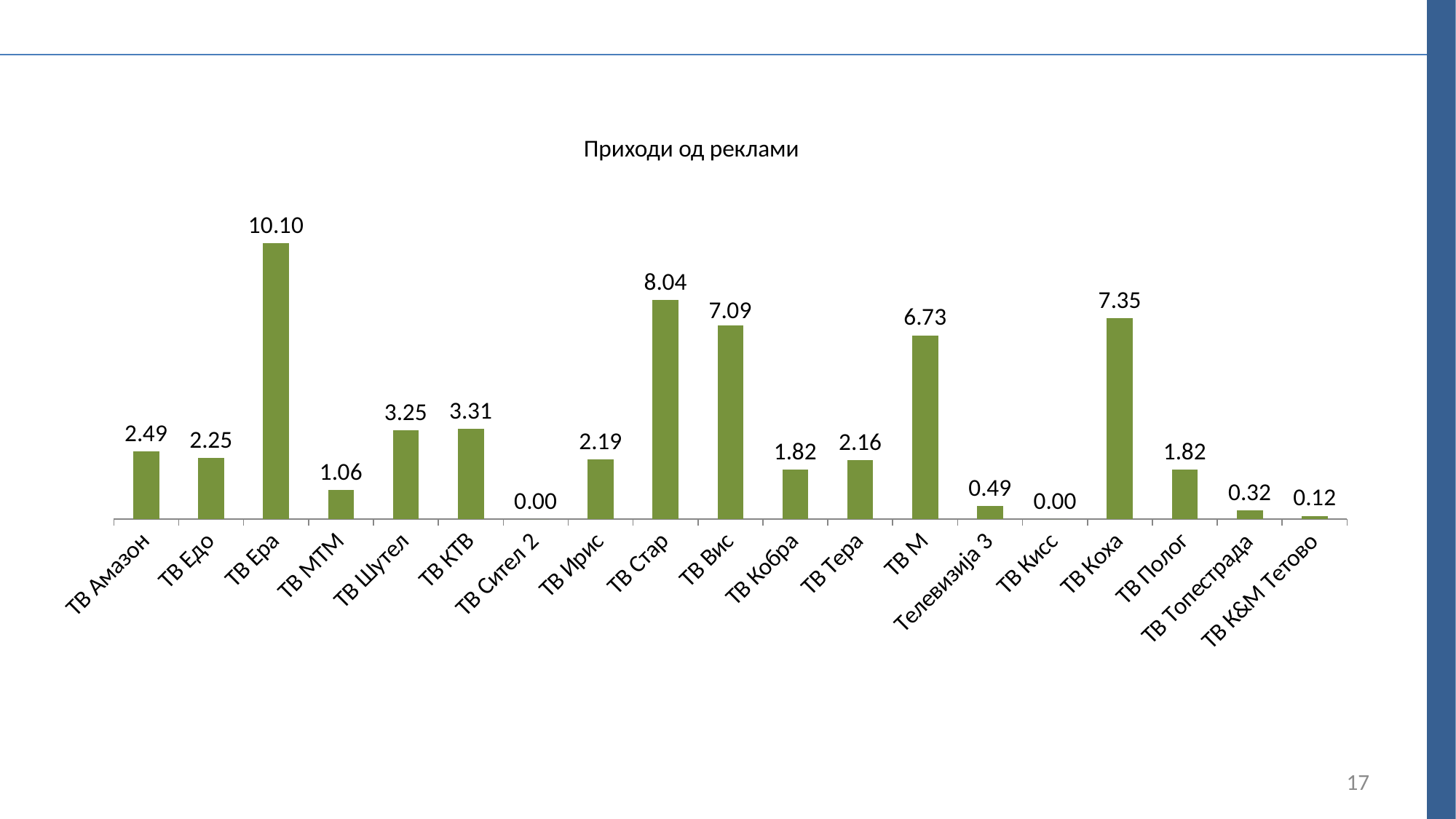
What kind of chart is shown on the slide? Bar chart Which is larger, the value for ТВ М or the value for ТВ Вис? ТВ Вис What is the title of the chart? Приходи од реклами What is the value for Телевизија 3? 0.49 How many categories are shown on the x axis? 19 What is the difference between the values for ТВ Стар and ТВ Вис? 0.95 What is the value for ТВ Шутел? 3.25 What is the value for ТВ Коха? 7.35 Which two categories have a value of 0.00? ТВ Сител 2 and ТВ Кисс What is the value for ТВ Ера? 10.10 What is the difference between the values for ТВ Ера and ТВ Коха? 2.75 Which category has the highest value? ТВ Ера